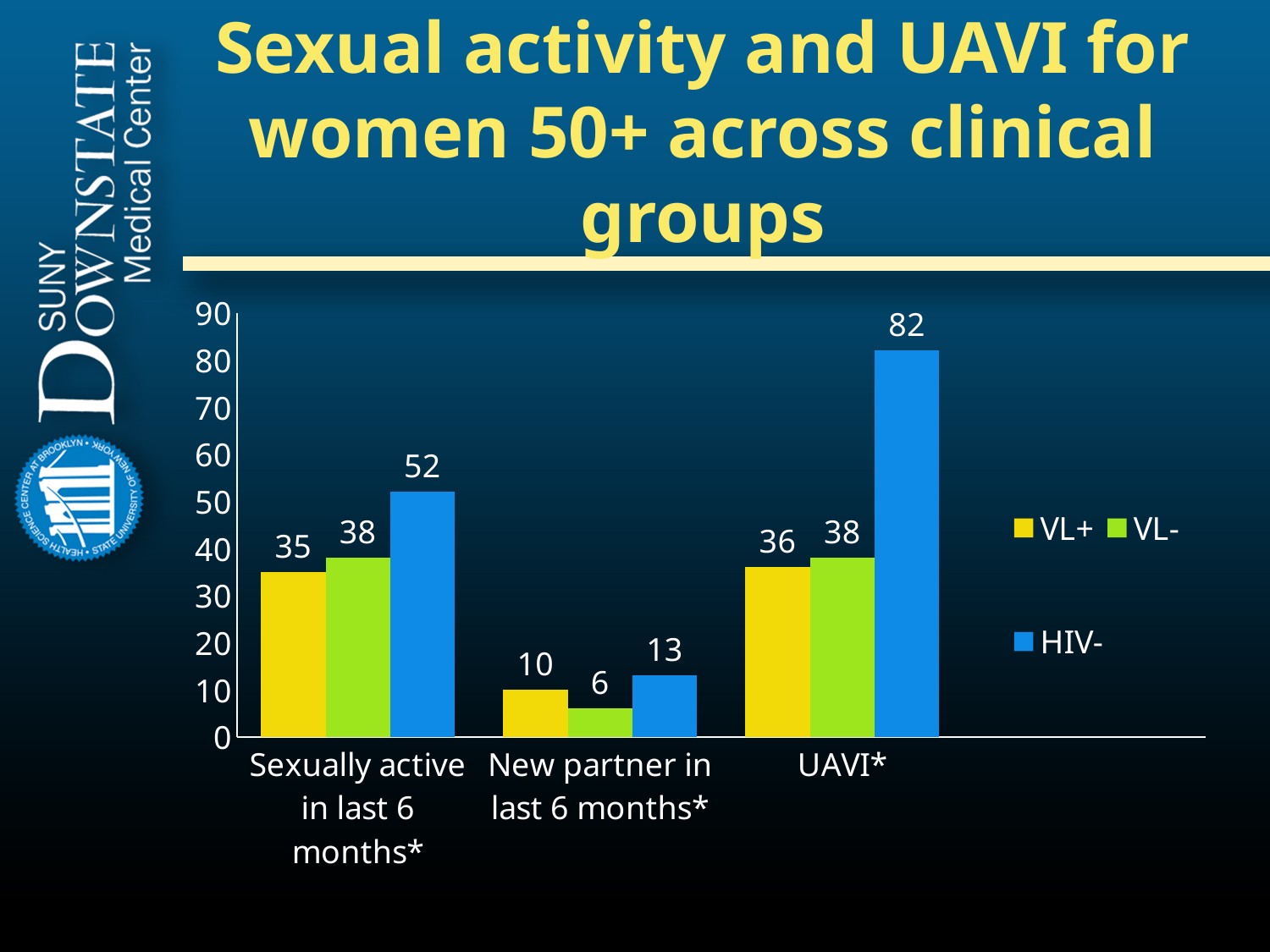
Is the HIV- value for UAVI* greater or less than 80? greater What is the value for VL- in the 'New partner in last 6 months*' category? 6 What is the value for HIV- in the UAVI* category? 82 What kind of chart is shown on the slide? Bar chart Which series has the highest value in the UAVI* category? HIV- How many series does the legend list? 3 Which is larger: the VL+ value or the HIV- value for 'New partner in last 6 months*'? HIV- What is the difference between the HIV- and VL+ values in the UAVI* category? 46 What is the difference between the HIV- and VL- values in the 'Sexually active in last 6 months*' category? 14 What is the value for VL+ in the 'Sexually active in last 6 months*' category? 35 How many categories are shown on the x axis? 3 Which series has the lowest value in the 'New partner in last 6 months*' category? VL-